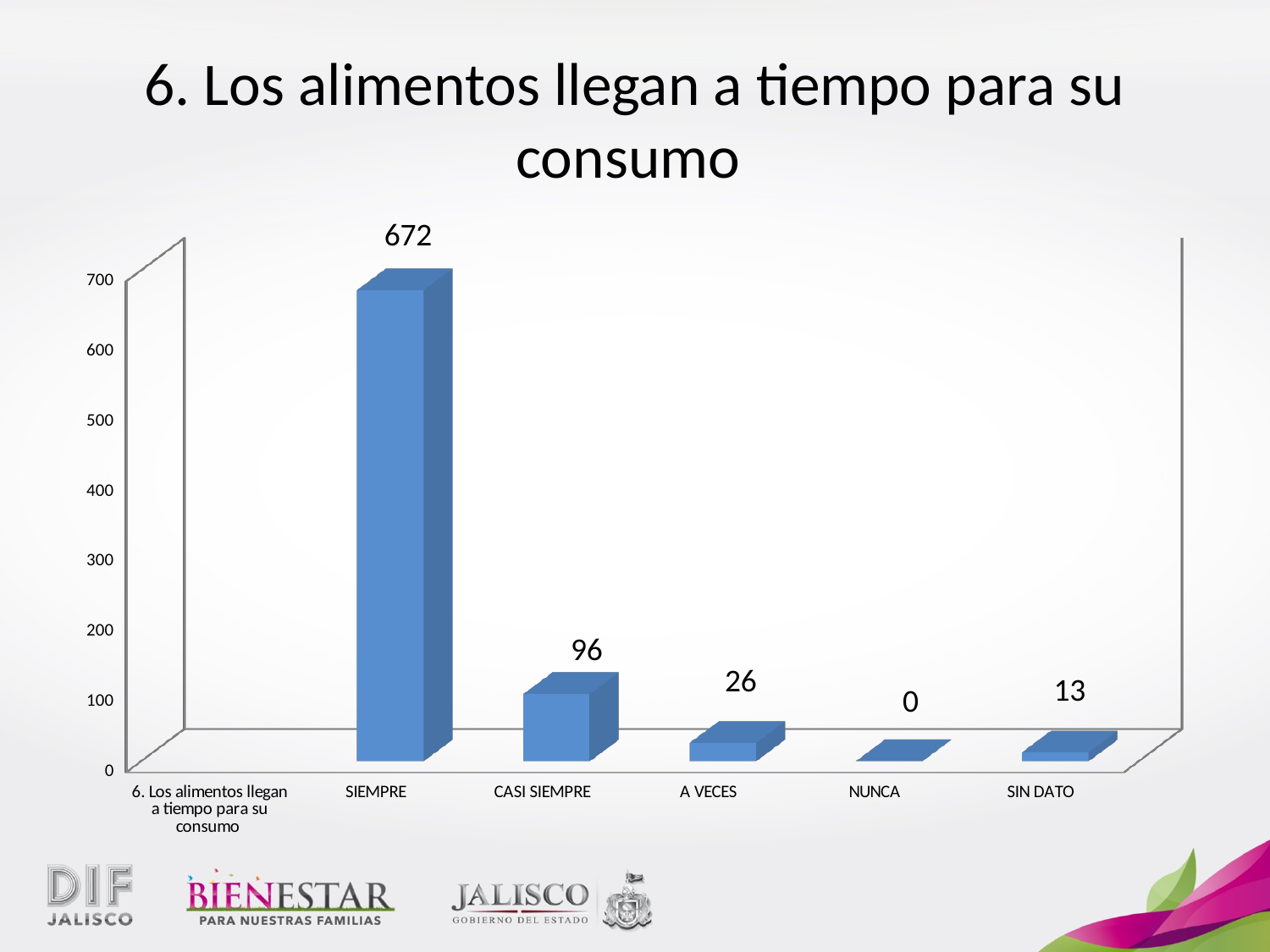
What is the title of the chart? 6. Los alimentos llegan a tiempo para su consumo What kind of chart is shown on the slide? bar chart What is the value for NUNCA? 0 Which category has the lowest value? NUNCA Which category has the highest value? SIEMPRE What is the difference between the values for SIEMPRE and CASI SIEMPRE? 576 Which is larger, the value for A VECES or the value for SIN DATO? A VECES What is the value for SIEMPRE? 672 Is the value for CASI SIEMPRE greater or less than 200? less What is the value for CASI SIEMPRE? 96 What is the value for SIN DATO? 13 What is the value for A VECES? 26